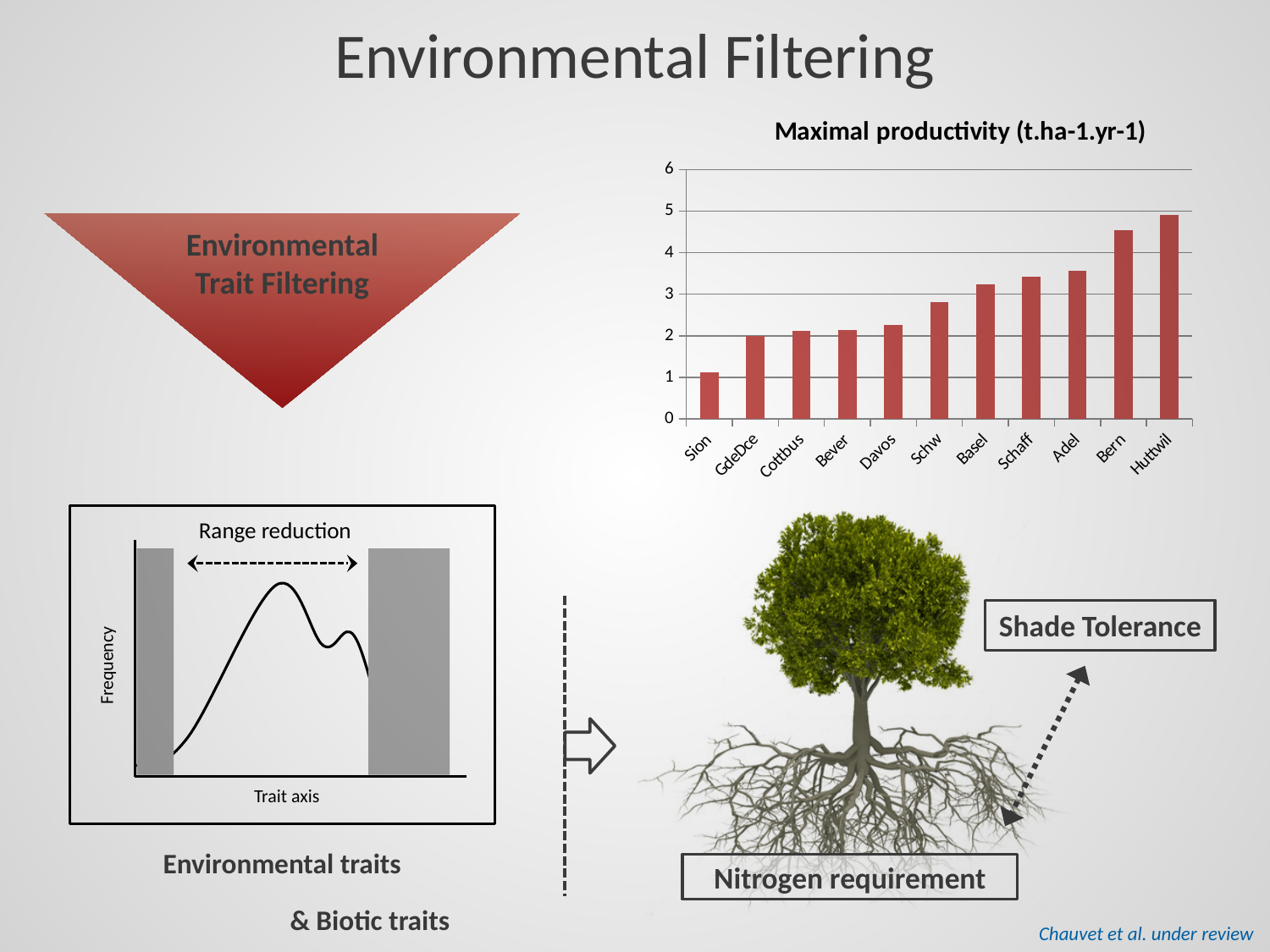
What is the highest tick value shown on the y axis of the 'Maximal productivity' chart? 6 What kind of chart is the 'Maximal productivity (t.ha-1.yr-1)' chart? bar chart In the 'Maximal productivity' chart, is the value for Adel greater or less than 3? greater Do the bars in the 'Maximal productivity' chart rise or fall from left to right? rise In the 'Maximal productivity' chart, which has the larger value, Davos or Basel? Basel In the 'Maximal productivity' chart, is the value for Schw greater or less than 3? less Which site has the lowest maximal productivity in the bar chart? Sion How many sites are shown on the x axis of the 'Maximal productivity' bar chart? 11 Which site has the highest maximal productivity in the bar chart? Huttwil In the 'Maximal productivity' chart, is the value for Huttwil greater or less than 4? greater In the 'Maximal productivity' chart, which has the larger value, Bern or Schw? Bern